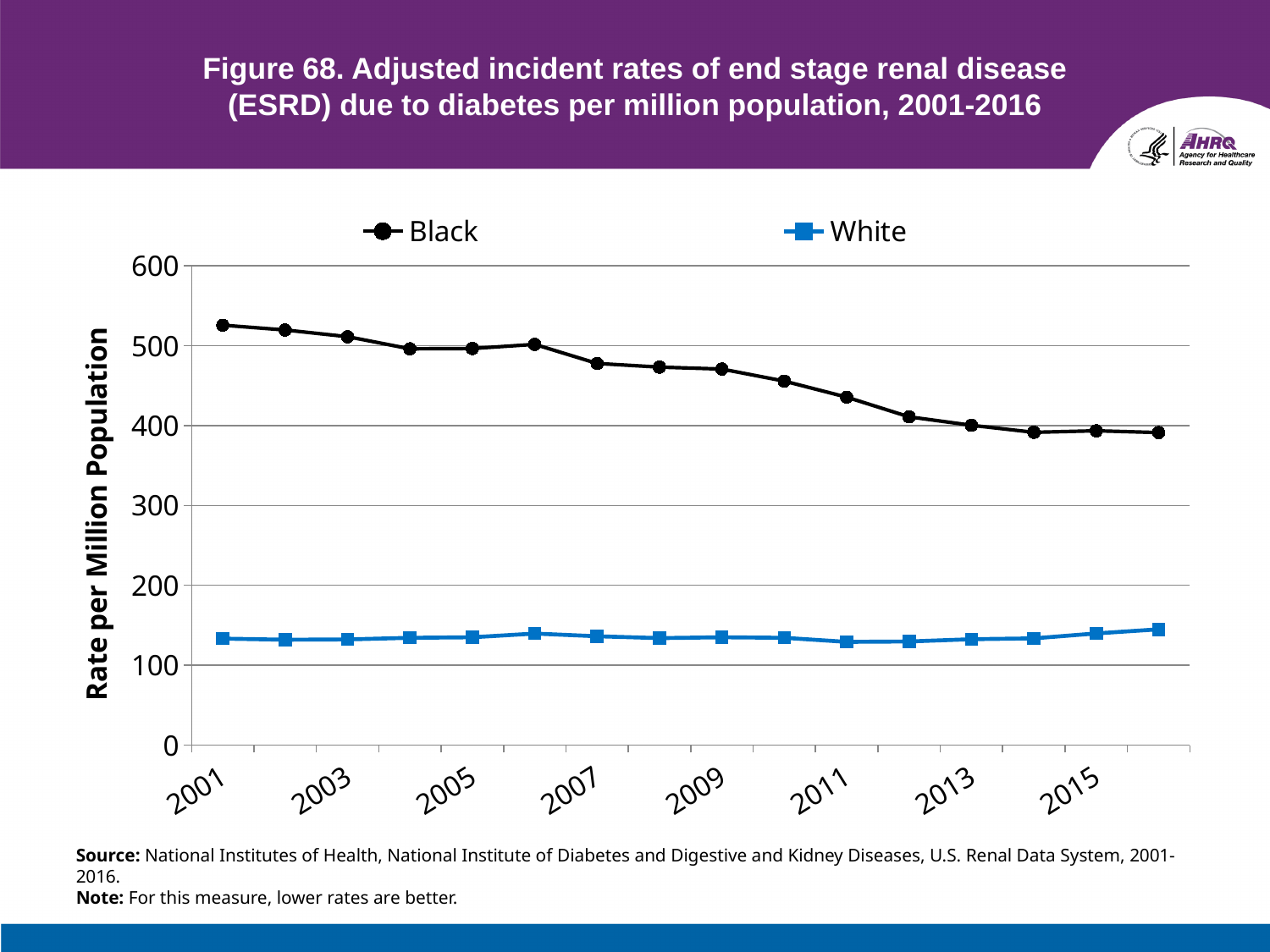
What kind of chart is shown on the slide? Line chart How many series does the legend list? 2 In which year is the rate for Black highest? 2001 Which two series are shown in the legend? Black and White Is the value for White in 2001 greater or less than 200? less Is the value for Black in 2001 greater or less than 500? greater What is the label on the vertical axis? Rate per Million Population Is the value for Black in 2011 greater or less than 400? greater In 2009, which series has the higher rate, Black or White? Black How many years (data points) are plotted for each series? 16 Does the rate for Black generally rise or fall from 2001 to 2016? Fall